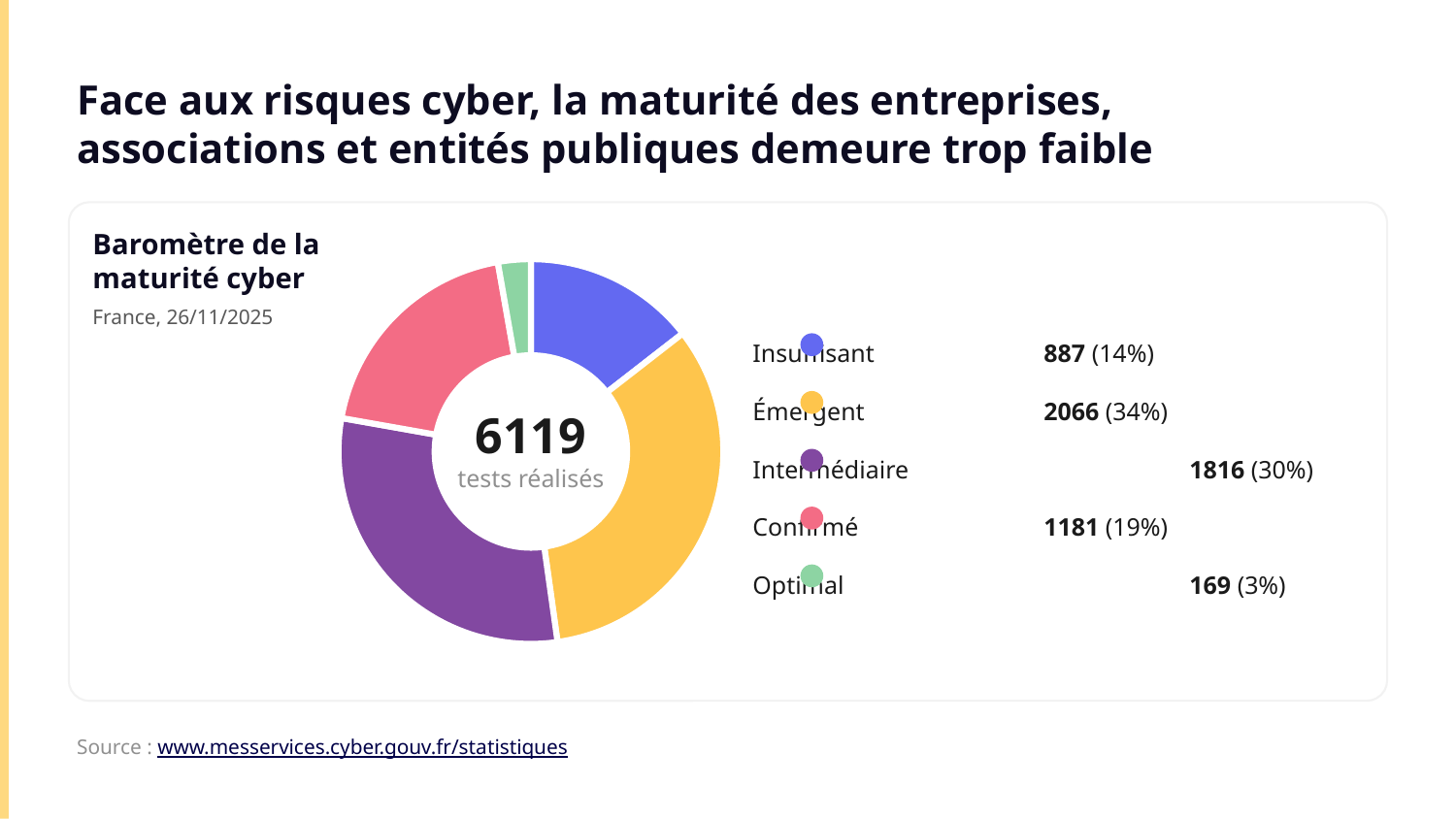
Which category has the lowest value? Optimal What percentage share does Intermédiaire have? 30% What kind of chart is shown on the slide? Donut chart What is the difference between the values for Émergent and Intermédiaire? 250 What is the value for Optimal? 169 Which category has the highest value? Émergent What is the title of the chart? Baromètre de la maturité cyber How many categories does the chart show? 5 Which is larger, the value for Confirmé or the value for Insuffisant? Confirmé What is the value for Émergent? 2066 How many tests does the centre of the donut chart say were carried out? 6119 What colour represents the Confirmé category? Pink